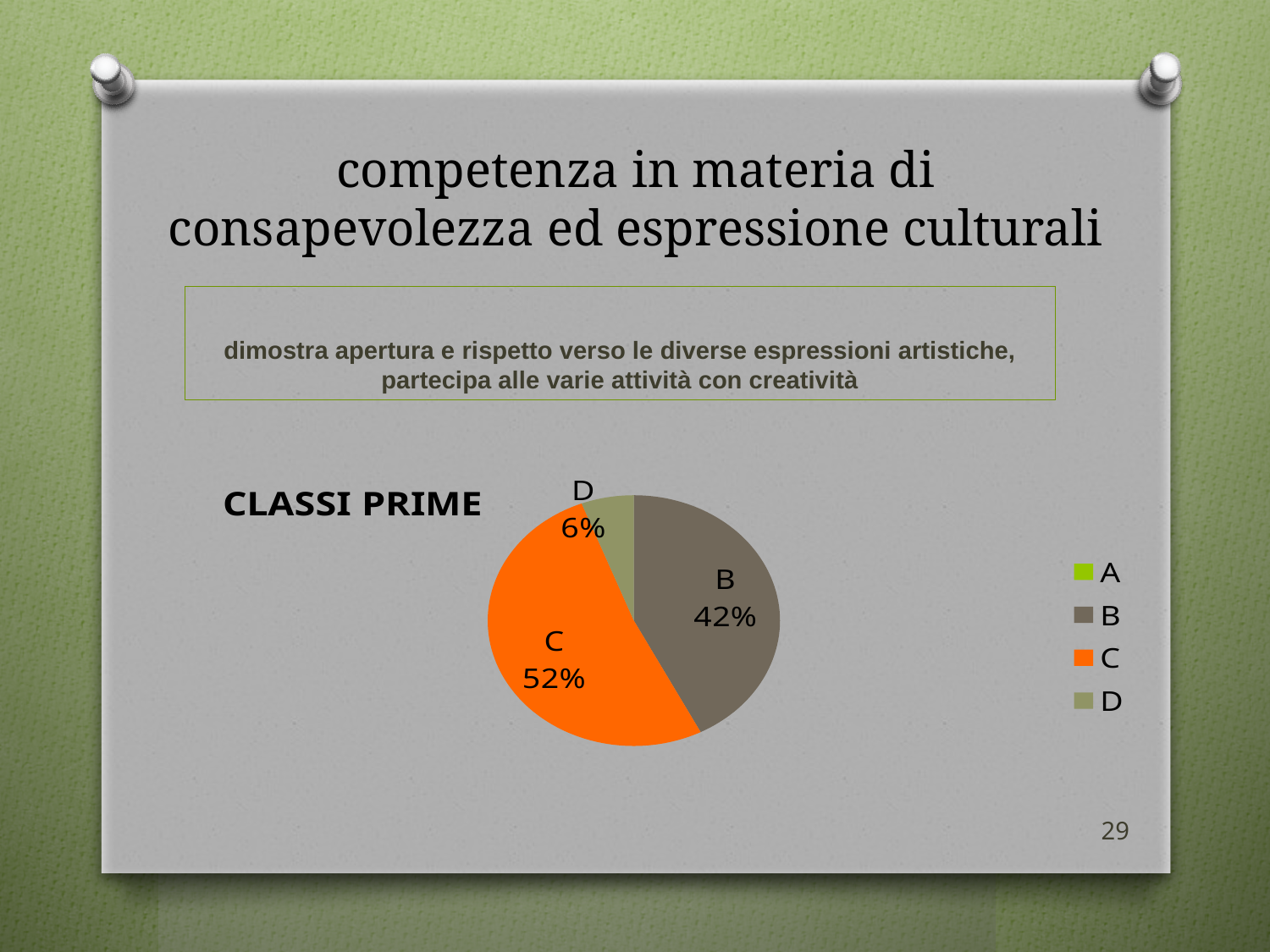
What is the share for category C in the pie chart? 52% Which category has the largest slice in the pie chart? C How many entries does the legend of the pie chart list? 4 What kind of chart is shown on the slide? pie chart What is the share for category B in the pie chart? 42% Which is larger in the pie chart, the share for B or the share for C? C Which labelled category has the smallest slice in the pie chart? D What is the share for category D in the pie chart? 6% What colour is the slice for category C in the pie chart? orange What label appears to the left of the pie chart? CLASSI PRIME What is the difference between the shares of C and B in the pie chart? 10% What is the difference between the shares of B and D in the pie chart? 36%